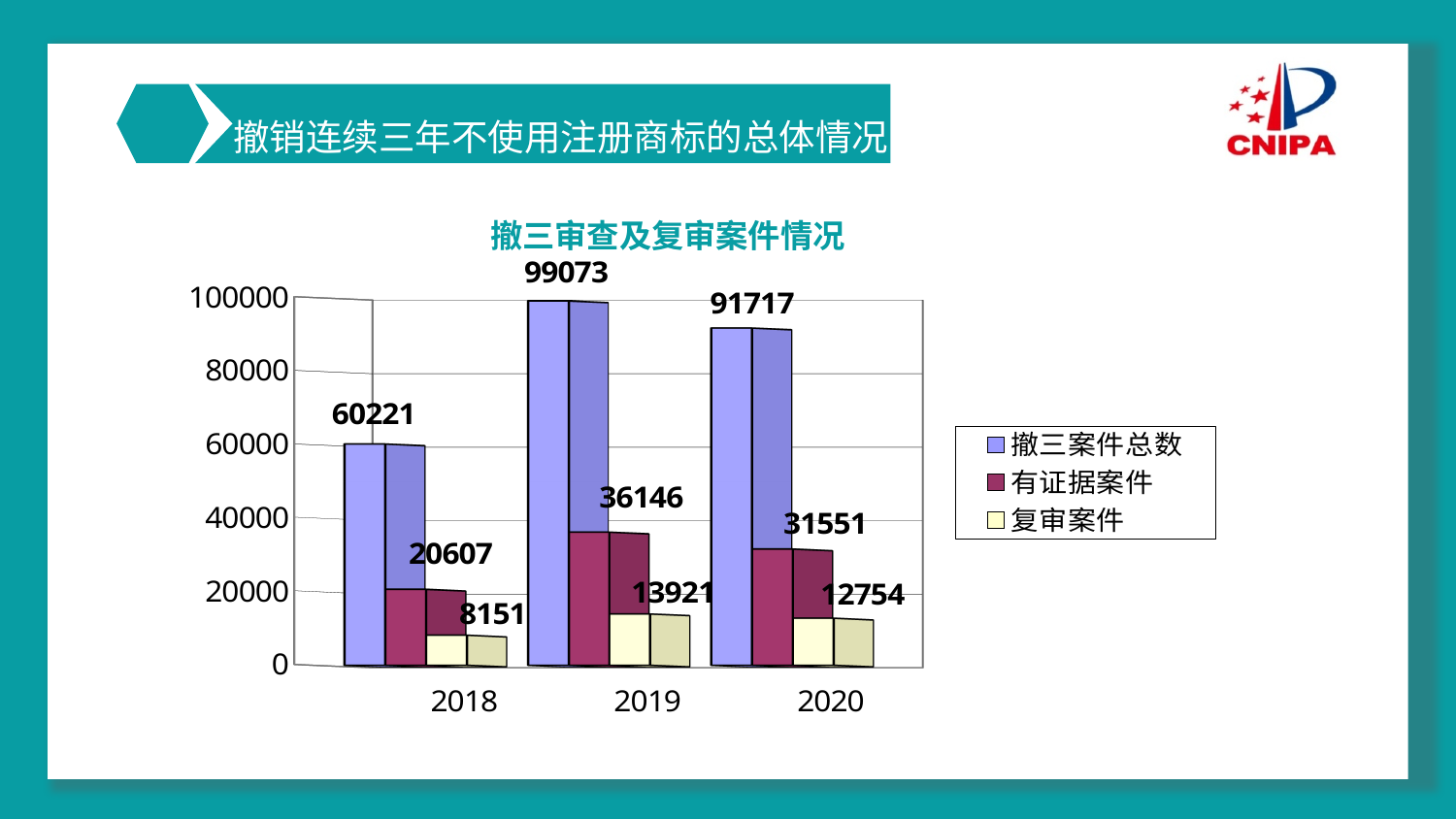
What is the value of 撤三案件总数 for 2019? 99073 Which is larger: 有证据案件 in 2020 or 有证据案件 in 2018? 2020 What is the value of 有证据案件 for 2018? 20607 What is the difference between 有证据案件 in 2019 and 2020? 4595 What is the difference between 撤三案件总数 in 2019 and 2018? 38852 What is the title of the chart? 撤三审查及复审案件情况 Which year has the highest value for 撤三案件总数? 2019 What kind of chart is shown on the slide? bar chart What is the value of 复审案件 for 2020? 12754 How many years are shown on the x axis? 3 Which year has the lowest value for 复审案件? 2018 How many series does the legend list? 3